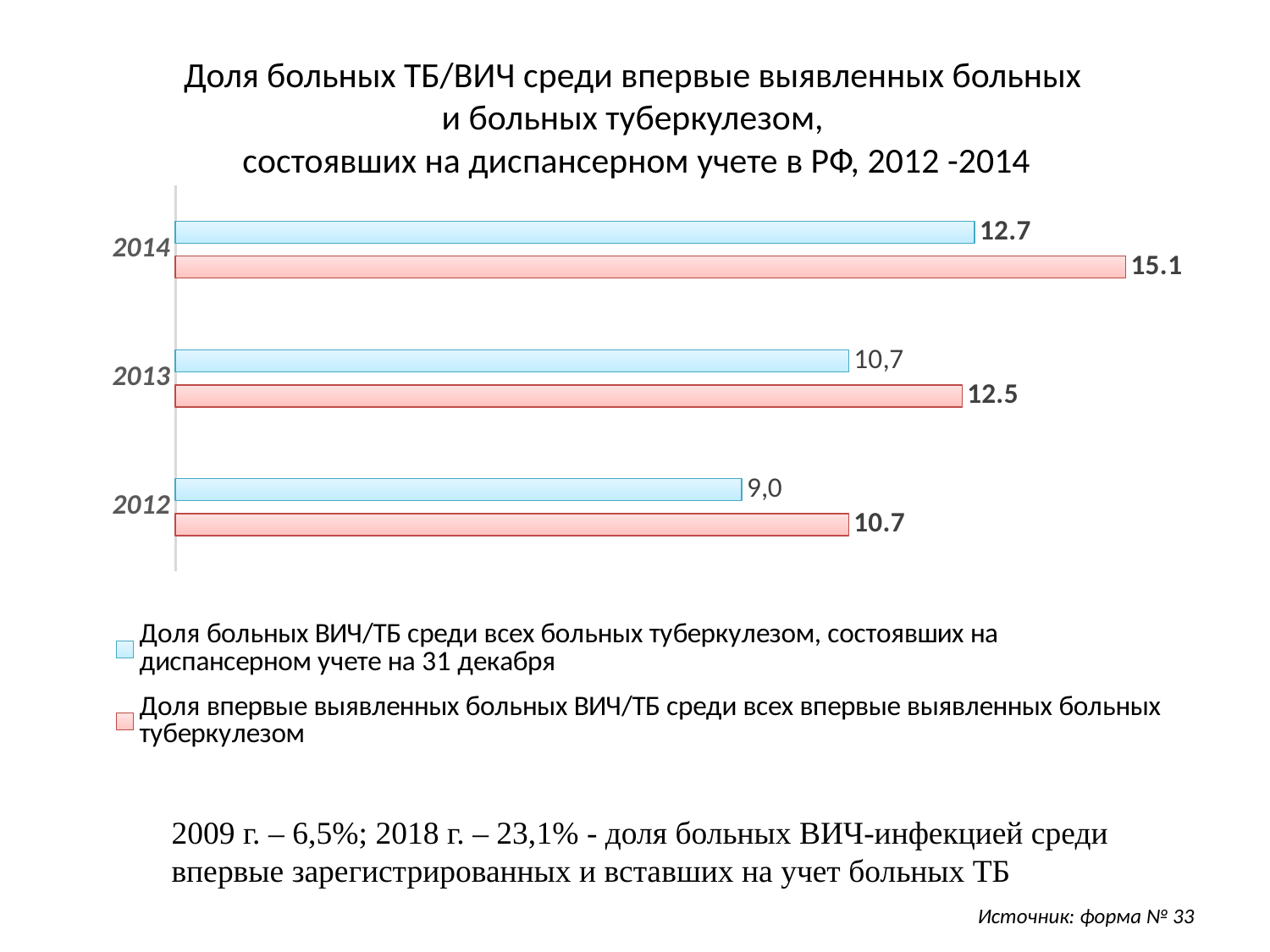
What is the value for 2014 for the series 'Доля впервые выявленных больных ВИЧ/ТБ среди всех впервые выявленных больных туберкулезом' (red bars)? 15.1 How many series does the legend list? 2 Which year has the lowest value for the blue series (patients on the dispensary register)? 2012 Which year has the highest value for the red series (newly detected HIV/TB patients)? 2014 What is the value for 2012 for the blue series (share among all TB patients on the dispensary register)? 9,0 What is the value for 2014 for the series 'Доля больных ВИЧ/ТБ среди всех больных туберкулезом, состоявших на диспансерном учете на 31 декабря' (blue bars)? 12.7 What is the difference between the red and blue values for 2014? 2.4 Do the values of the blue series rise or fall from 2012 to 2014? rise How many years (categories) are shown on the chart? 3 What kind of chart is shown on the slide? bar chart Which is larger in 2013: the red series value or the blue series value? the red series (12.5) What is the value for 2013 for the red series (share of newly detected HIV/TB patients among all newly detected TB patients)? 12.5